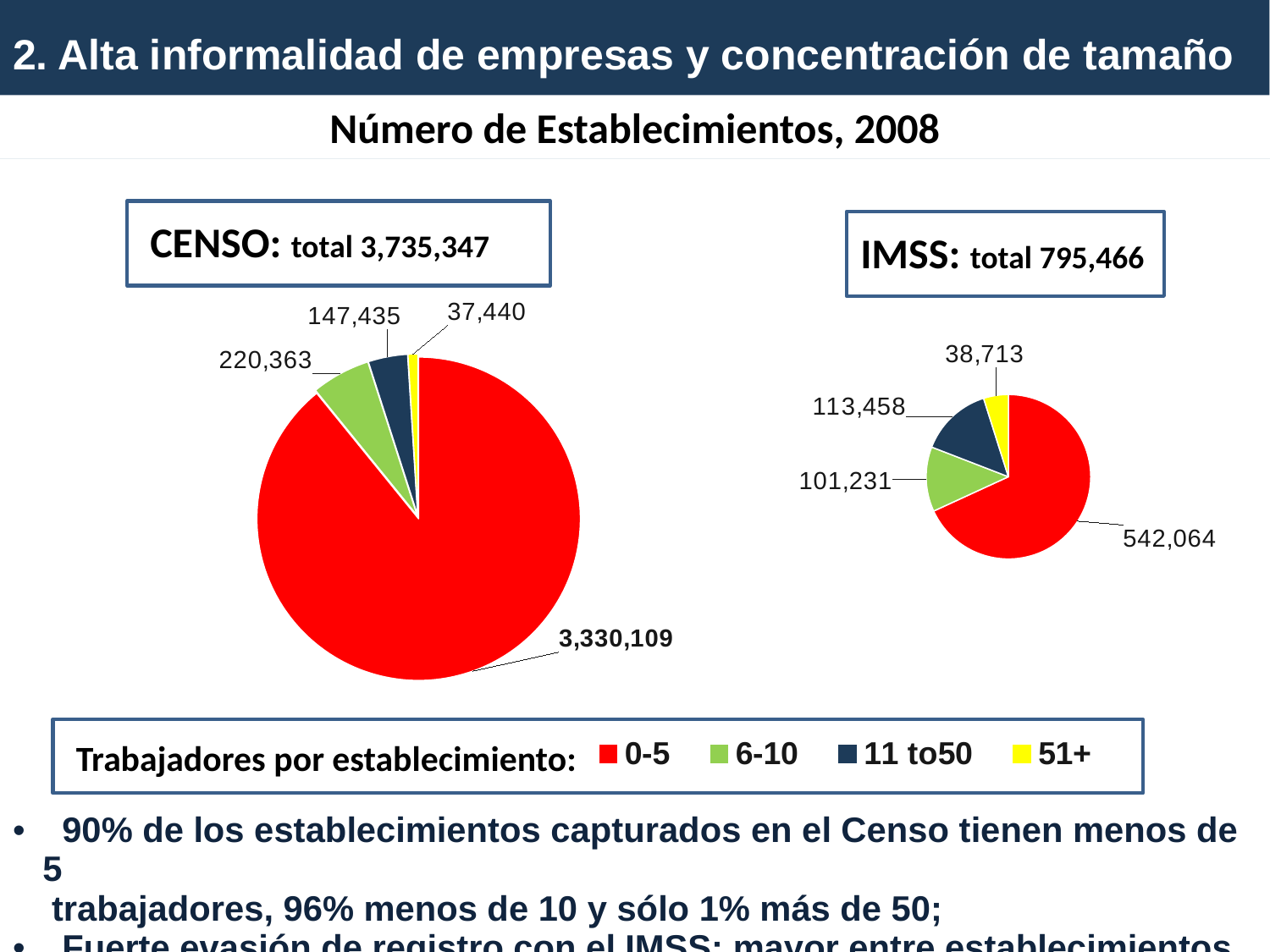
In the IMSS pie chart, what is the difference between the 11 to 50 category and the 6-10 category? 12,227 In the CENSO pie chart, what is the difference between the 6-10 category and the 11 to 50 category? 72,928 In the CENSO pie chart, which category has the largest number of establishments? 0-5 In the CENSO pie chart, how many establishments have 0-5 workers? 3,330,109 What type of chart is used to show the number of establishments for CENSO and IMSS? Pie chart In the IMSS pie chart, how many establishments have 11 to 50 workers? 113,458 In the CENSO pie chart, what is the value for establishments with 51+ workers? 37,440 In the IMSS pie chart, which category has the smallest number of establishments? 51+ What colour represents the 51+ workers category in the legend? Yellow How many slices does the CENSO pie chart have? 4 In the IMSS pie chart, which is larger: the 6-10 category or the 11 to 50 category? 11 to 50 In the IMSS pie chart, what is the value for establishments with 6-10 workers? 101,231